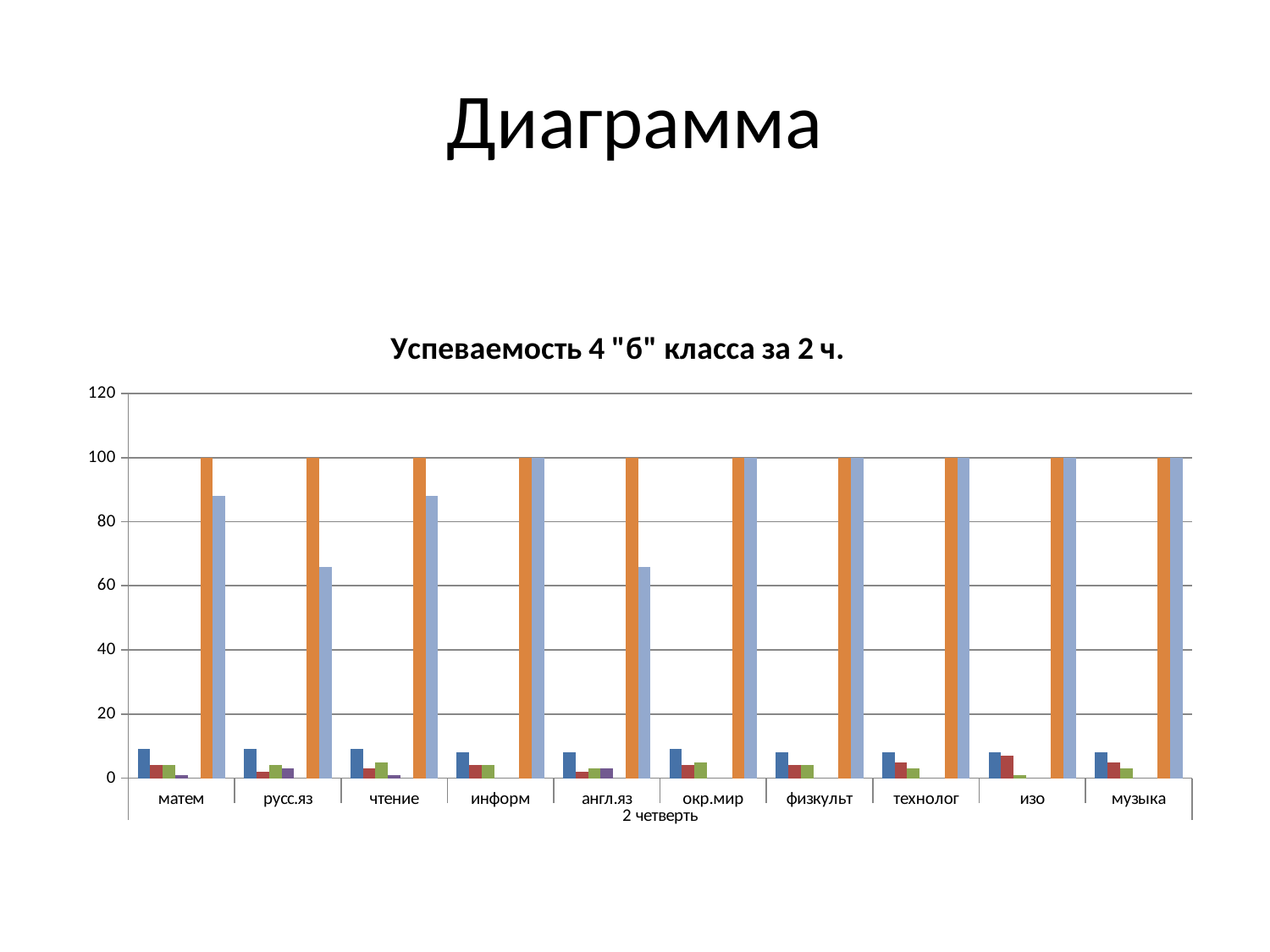
Which is larger, the light blue bar for матем or the light blue bar for русс.яз? матем What kind of chart is shown on the slide? bar chart What is the title of the chart? Успеваемость 4 "б" класса за 2 ч. What value does the orange bar for матем reach? 100 Is the light blue bar for матем greater or less than 80? greater Is the light blue bar for англ.яз greater or less than 60? greater What label is shown under the category axis? 2 четверть Which is larger, the light blue bar for чтение or the light blue bar for англ.яз? чтение Is the light blue bar for русс.яз greater or less than 80? less How many subject categories are shown along the x axis? 10 What value does the light blue bar for информ reach? 100